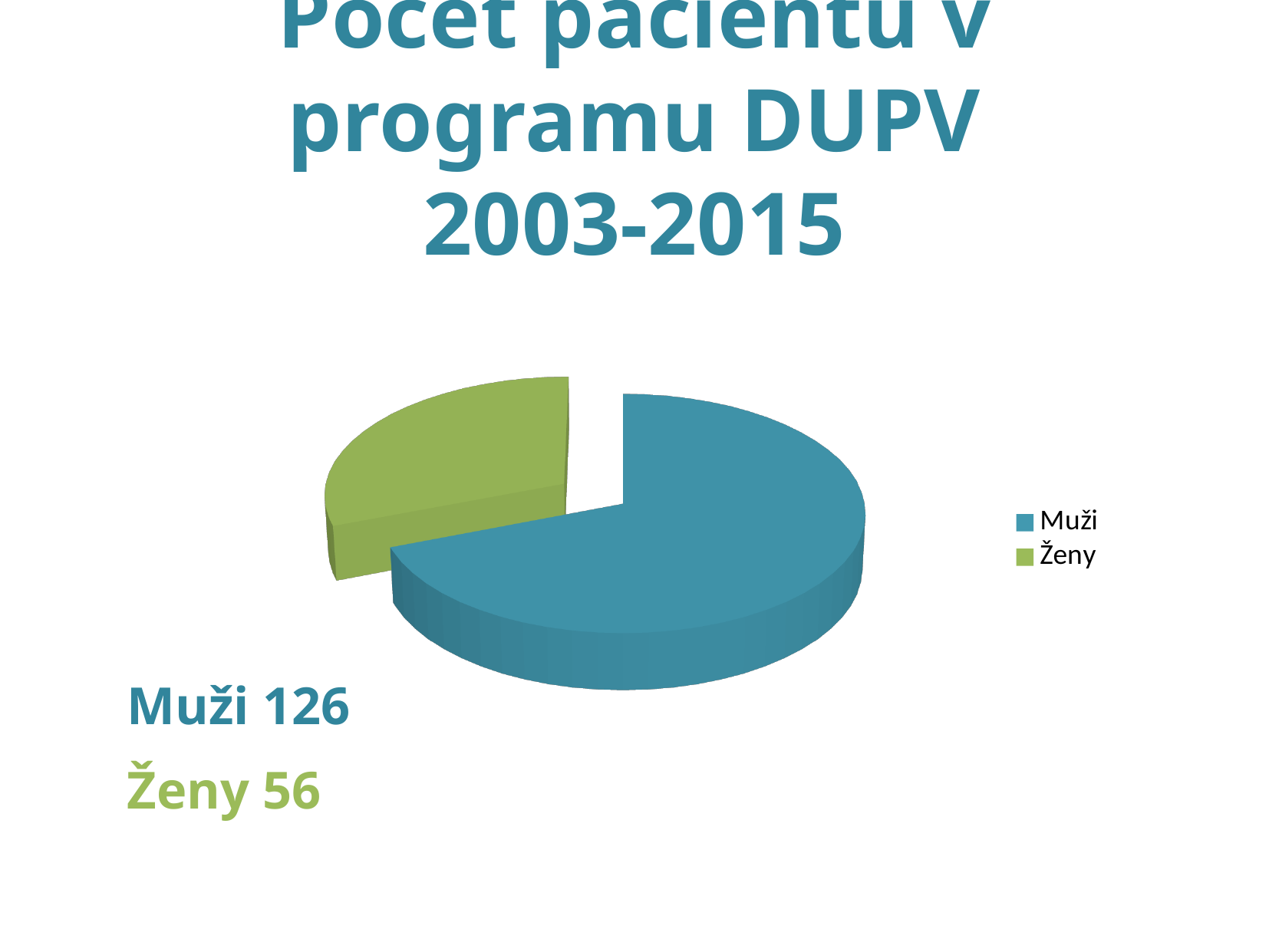
What is the difference between the value for Muži and the value for Ženy? 70 How many entries does the legend list? 2 How many slices does the pie chart have? 2 What is the value for Muži? 126 Which is larger, the value for Muži or the value for Ženy? Muži Which category has the largest slice of the pie? Muži Which category has the smallest slice of the pie? Ženy What is the title of the chart? Počet pacientů v programu DUPV 2003-2015 What is the total number of patients across both slices? 182 What kind of chart is shown on the slide? pie chart What colour is the Ženy slice? green What is the value for Ženy? 56